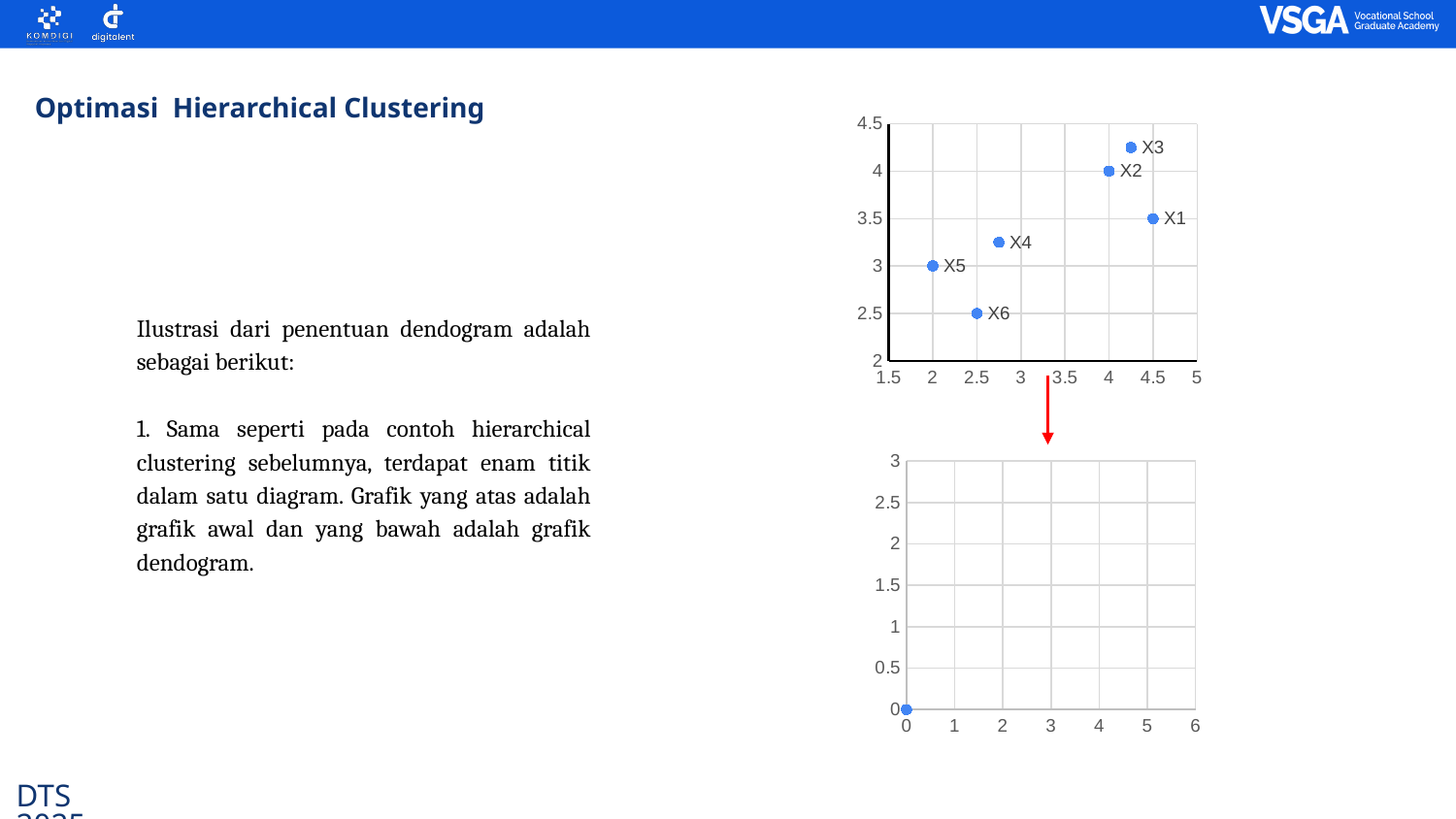
In the top chart, which labeled point has the lowest y-axis value? X6 In the top chart, which labeled point is farthest to the left on the x axis? X5 In the top chart, what is the x-axis value of point X5? 2 In the top chart, what is the y-axis value of point X5? 3 In the top chart, what is the x-axis value of point X2? 4 In the top chart, how many labeled data points are plotted? 6 In the top chart, what is the y-axis value of point X1? 3.5 In the top chart, which point has a larger y-axis value, X4 or X5? X4 In the top chart, what is the y-axis value of point X6? 2.5 In the top chart, is the y-axis value of point X3 greater or less than 4? greater In the top chart, which labeled point has the highest y-axis value? X3 In the top chart, what kind of chart is shown? scatter chart